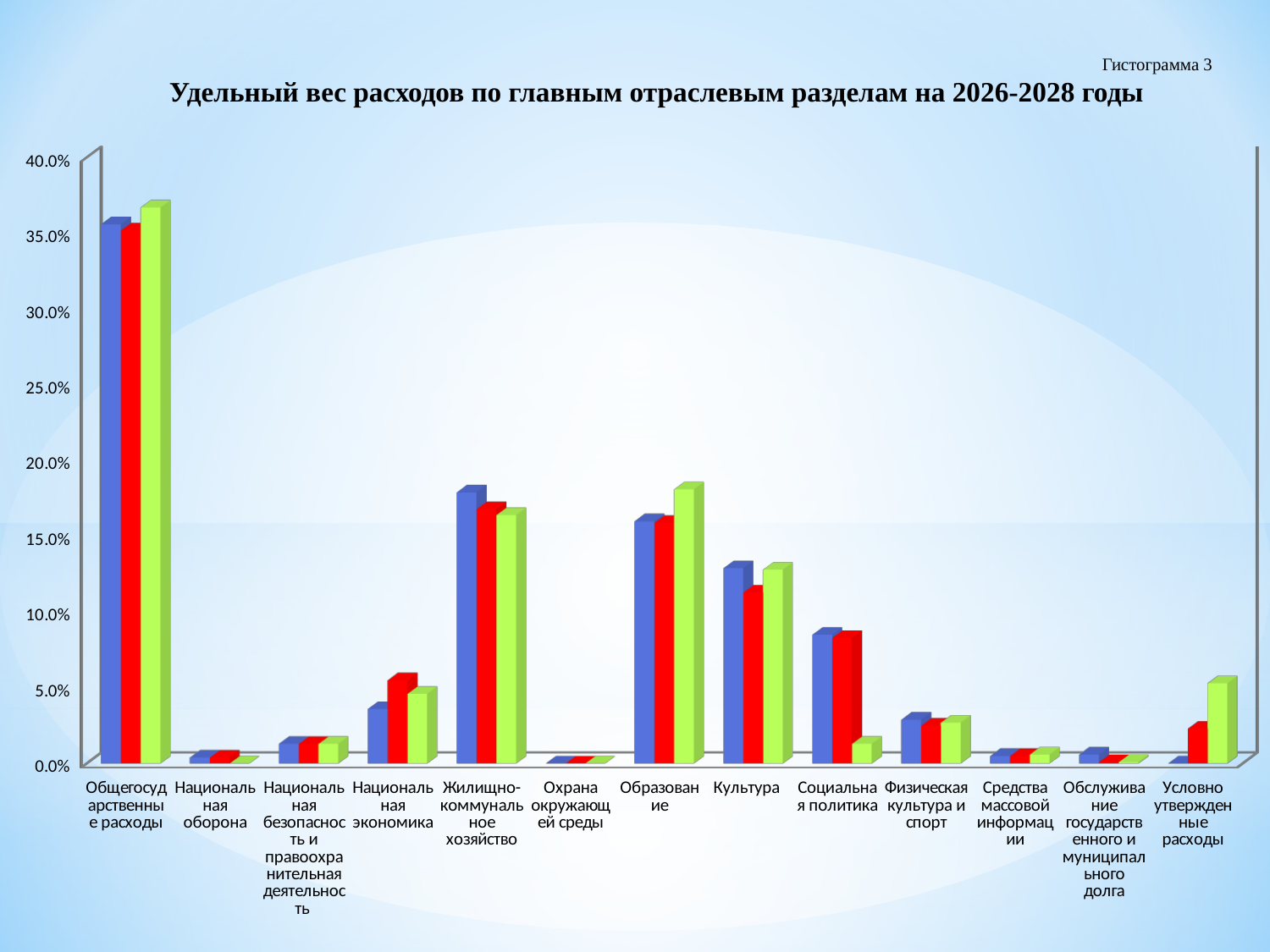
Is the value of the green bar for Общегосударственные расходы greater or less than 35.0%? greater Which category has the lowest bars in the chart? Охрана окружающей среды What kind of chart is shown on the slide? bar chart Is the value of the green bar for Образование greater or less than 15.0%? greater Which has the larger blue bar, Образование or Культура? Образование For Социальная политика, which bar is larger, the blue one or the green one? the blue one Is the value of the blue bar for Жилищно-коммунальное хозяйство greater or less than 15.0%? greater What is the title of the chart? Удельный вес расходов по главным отраслевым разделам на 2026-2028 годы How many categories are shown along the x axis of the chart? 13 Which category has the highest bars in the chart? Общегосударственные расходы